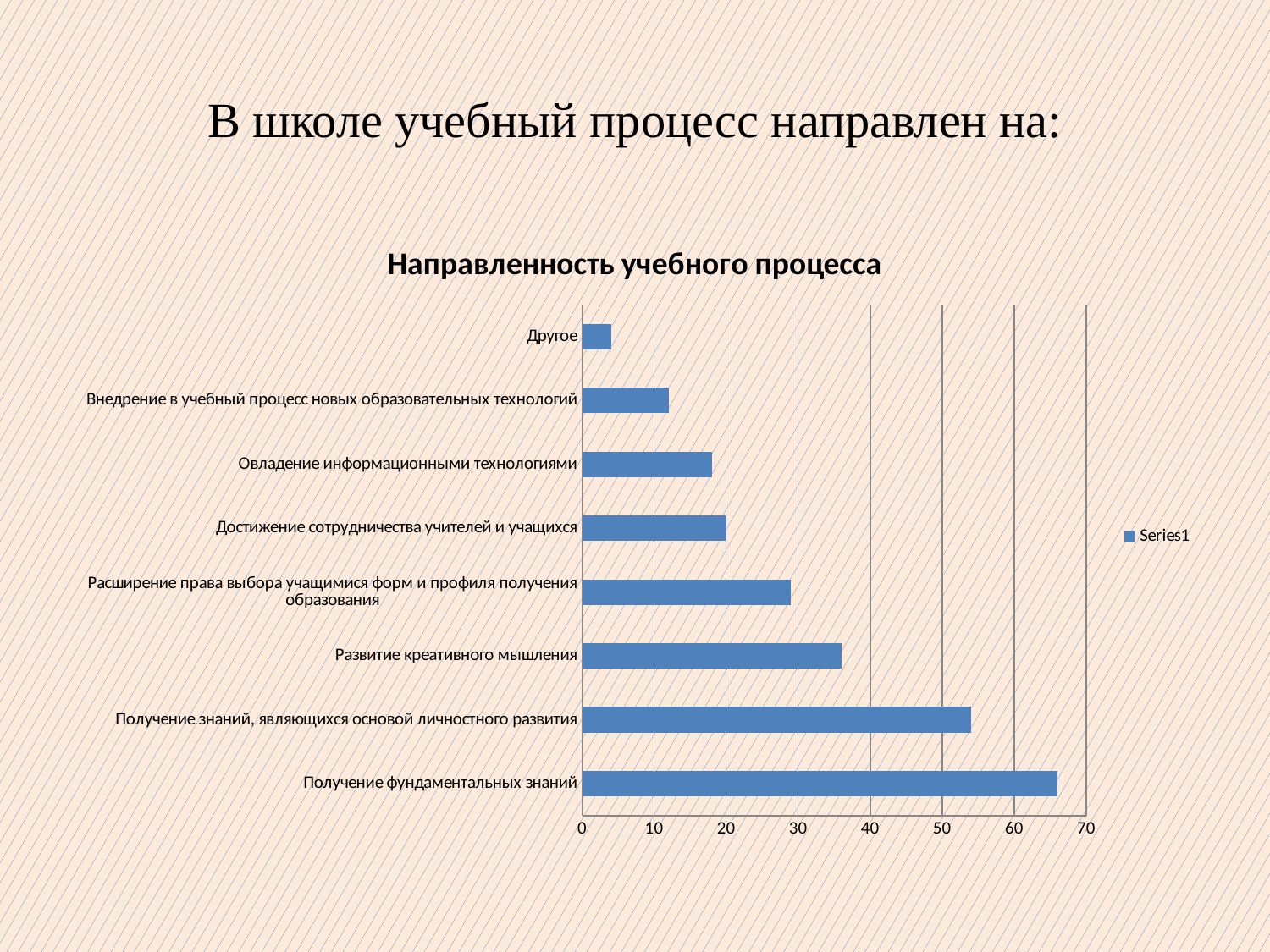
How many categories are plotted in the chart? 8 Is the value for Развитие креативного мышления greater or less than 40? less How many series does the legend list? 1 What kind of chart is shown on the slide? bar chart What is the title of the chart? Направленность учебного процесса Which is larger: the value for Внедрение в учебный процесс новых образовательных технологий or the value for Другое? Внедрение в учебный процесс новых образовательных технологий Is the value for Получение фундаментальных знаний greater or less than 60? greater Is the value for Другое greater or less than 10? less Which category has the highest value? Получение фундаментальных знаний Which category has the lowest value? Другое Which is larger: the value for Развитие креативного мышления or the value for Расширение права выбора учащимися форм и профиля получения образования? Развитие креативного мышления